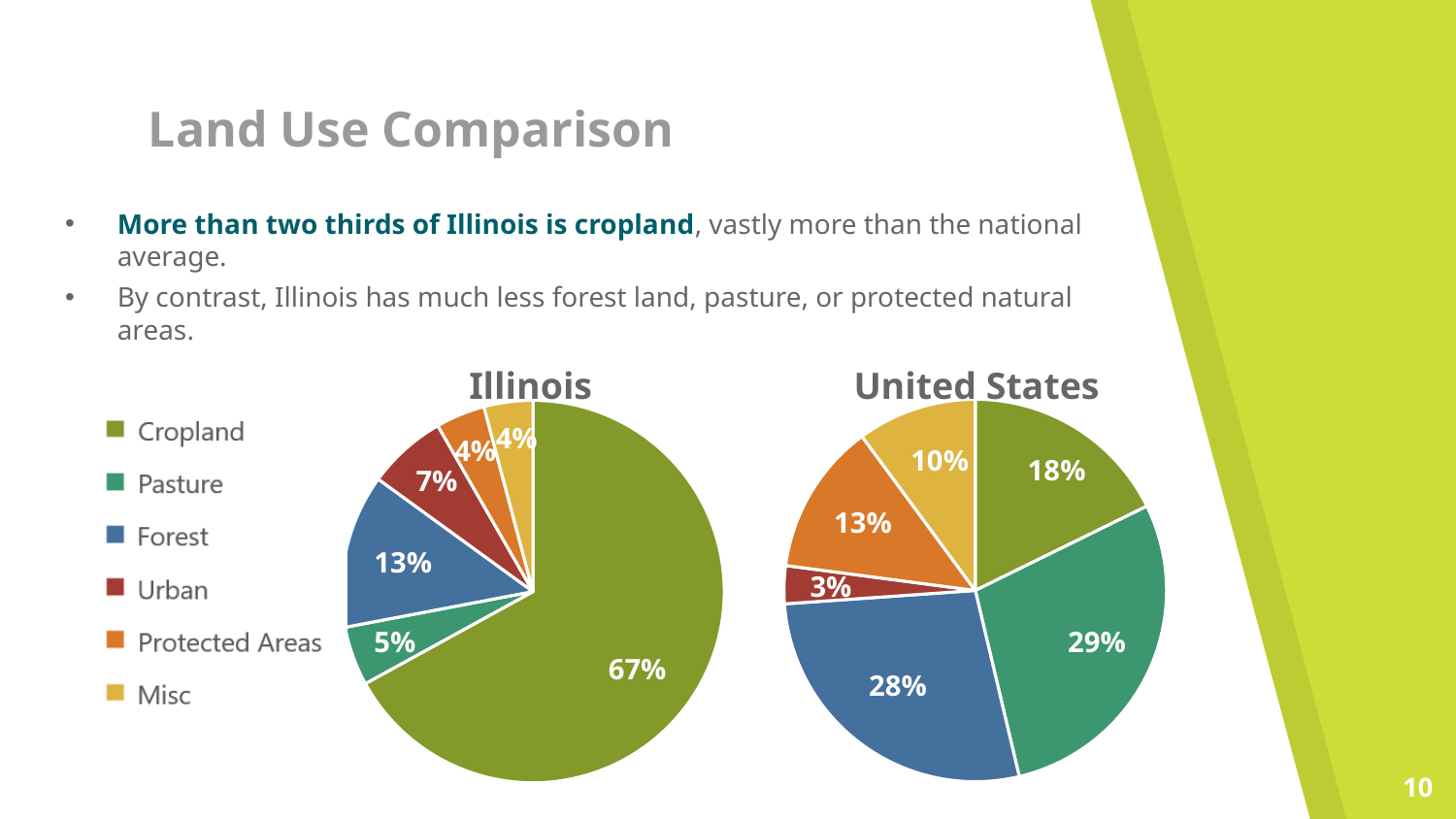
In the Illinois chart, what share of land is cropland? 67% In the United States chart, which category has the largest share? Pasture In the United States chart, which category has the smallest share? Urban What colour represents Protected Areas in the legend? Orange In the United States chart, what share of land is forest? 28% In the United States chart, what share of land is pasture? 29% In the Illinois chart, what share of land is urban? 7% What kind of charts are shown on the slide? Pie charts How many categories does the legend list? 6 Which is larger: the forest share in the Illinois chart or the forest share in the United States chart? United States In the Illinois chart, which category has the largest share? Cropland What is the difference between the cropland share in the Illinois chart and the cropland share in the United States chart? 49%